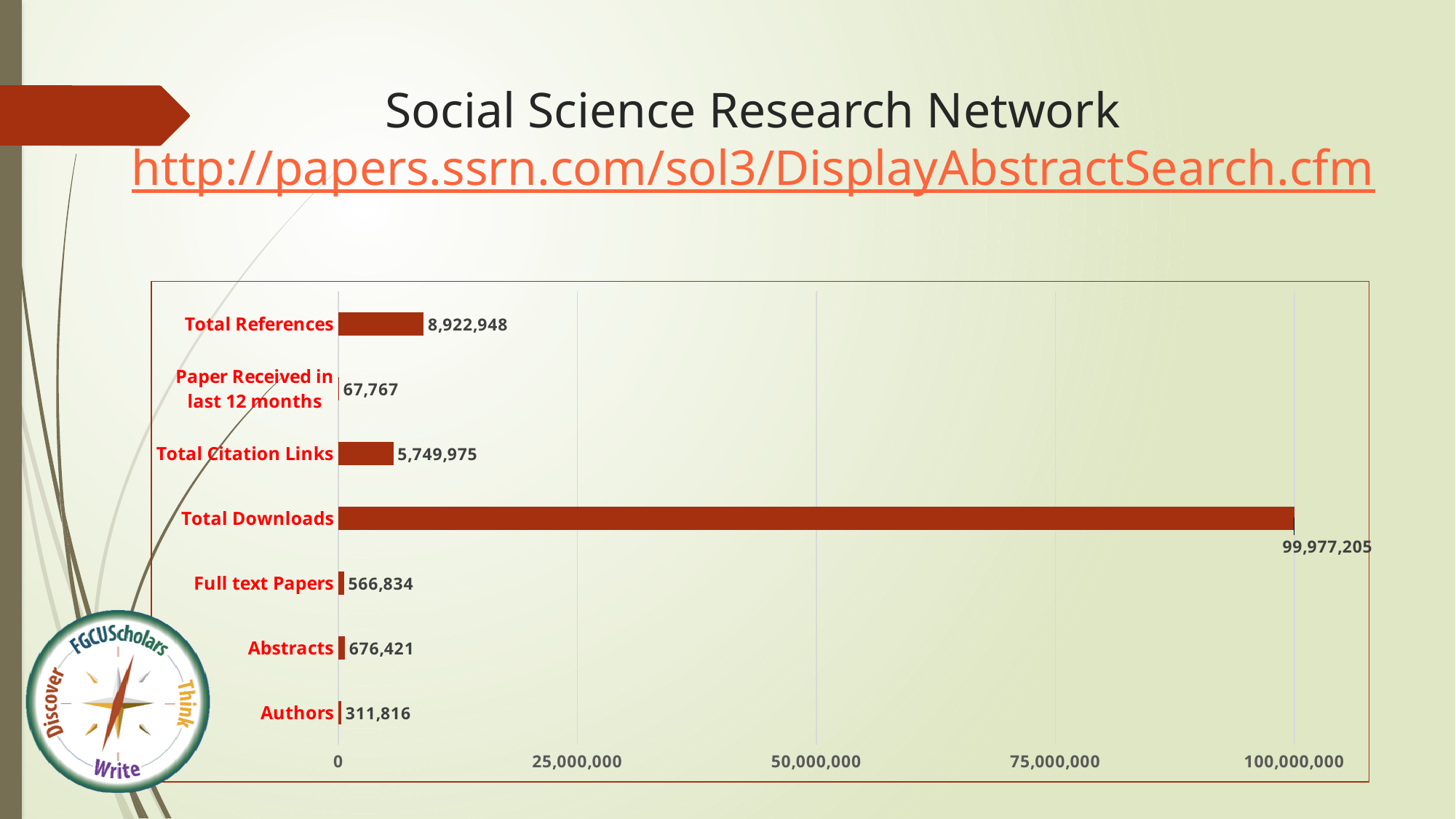
What is the value for Total References? 8,922,948 Is the value for Total Downloads greater or less than 75,000,000? greater What is the difference between Total References and Total Citation Links? 3,172,973 How many categories are shown in the chart? 7 What is the value for Authors? 311,816 What is the value for Paper Received in last 12 months? 67,767 What is the value for Total Downloads? 99,977,205 Which is larger, Abstracts or Full text Papers? Abstracts What kind of chart is shown on the slide? bar chart Which category has the lowest value? Paper Received in last 12 months Which category has the highest value? Total Downloads What is the difference between Abstracts and Full text Papers? 109,587